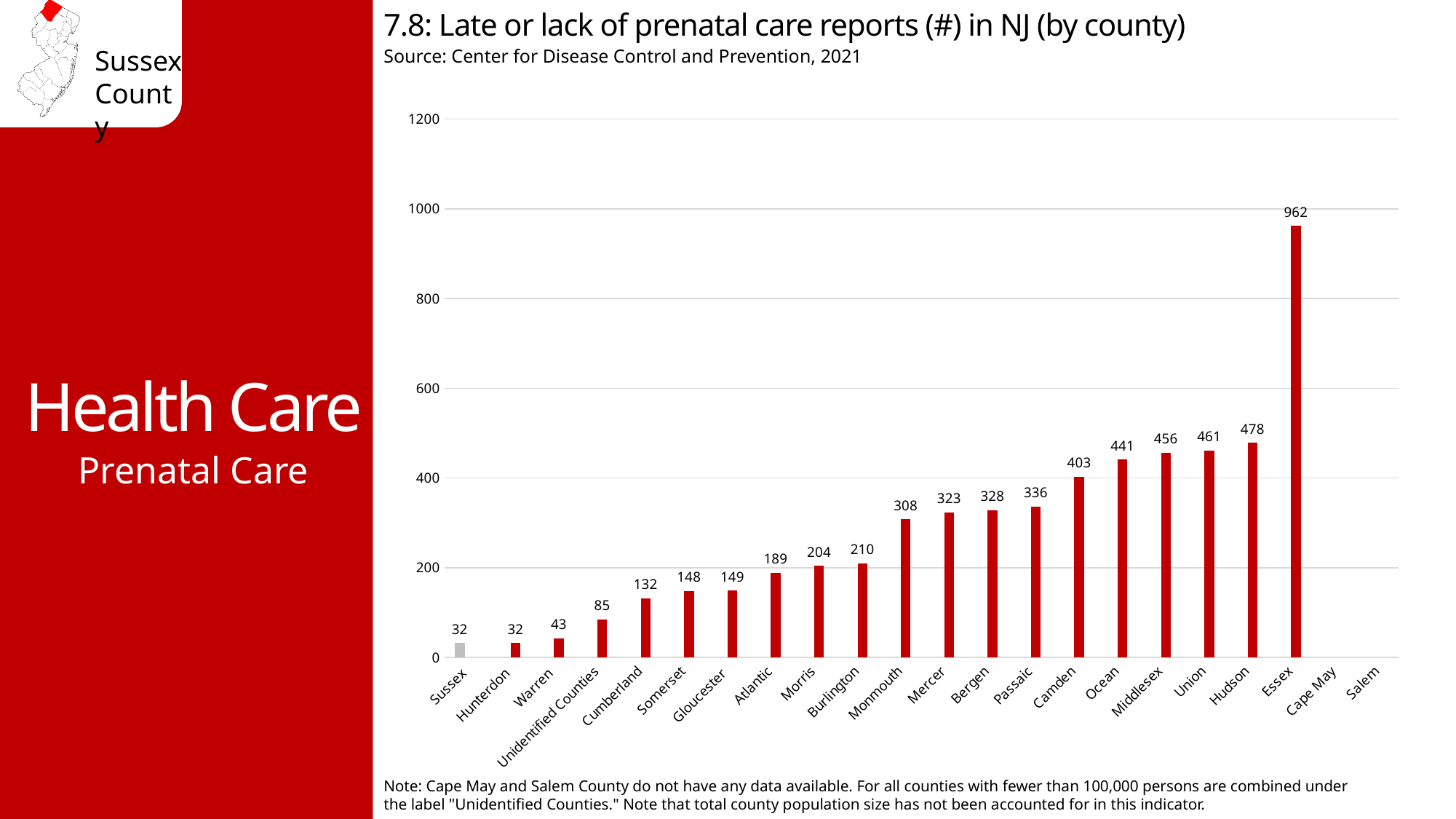
How many counties (categories) are shown on the x axis? 22 Which two counties have no data available according to the note? Cape May and Salem Which county has the highest number of late or lack of prenatal care reports? Essex What kind of chart is shown on the slide? bar chart Do the values generally rise or fall moving from left to right along the x axis? rise Which is larger, the value for Camden or the value for Passaic? Camden What is the value for Essex? 962 What is the value for Monmouth? 308 What is the difference between the values for Hudson and Union? 17 Is the value for Ocean greater or less than 400? greater What is the value for Sussex? 32 What is the difference between the values for Essex and Hudson? 484